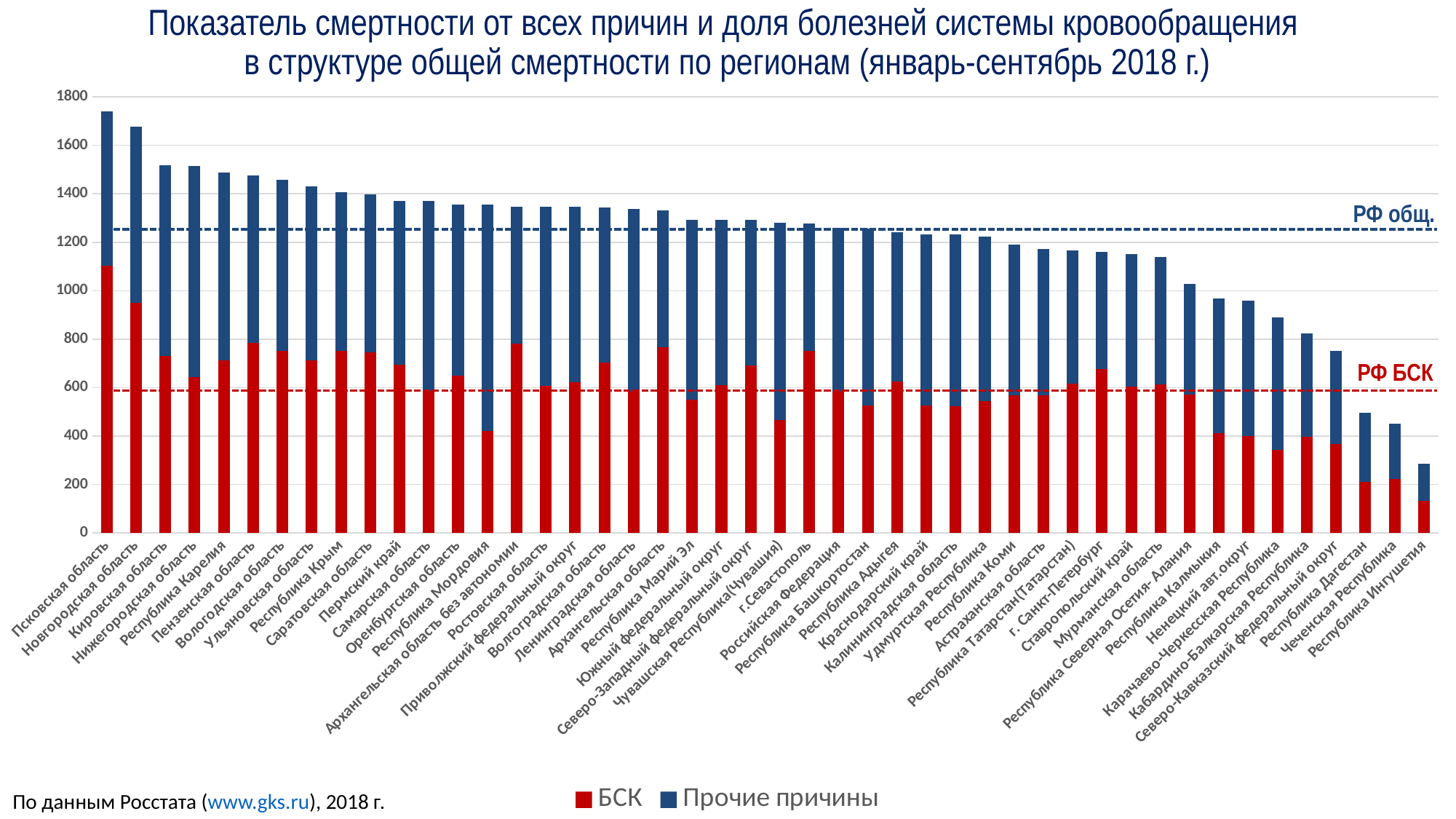
Is the БСК value for Псковская область greater or less than 1000? greater Which has the larger total bar, Новгородская область or Кировская область? Новгородская область How many series does the legend list? 2 What kind of chart is shown on the slide? Stacked bar chart Which region has the lowest total bar? Республика Ингушетия Which region has the highest total bar? Псковская область Is the total value for Республика Ингушетия greater or less than 400? less What are the two series named in the legend? БСК and Прочие причины Which region has the tallest red (БСК) segment? Псковская область Is the total value for Псковская область greater or less than 1600? greater Which has the larger БСК (red) segment, Республика Мордовия or Ростовская область? Ростовская область Do the total bar heights rise or fall from left to right along the x axis? fall